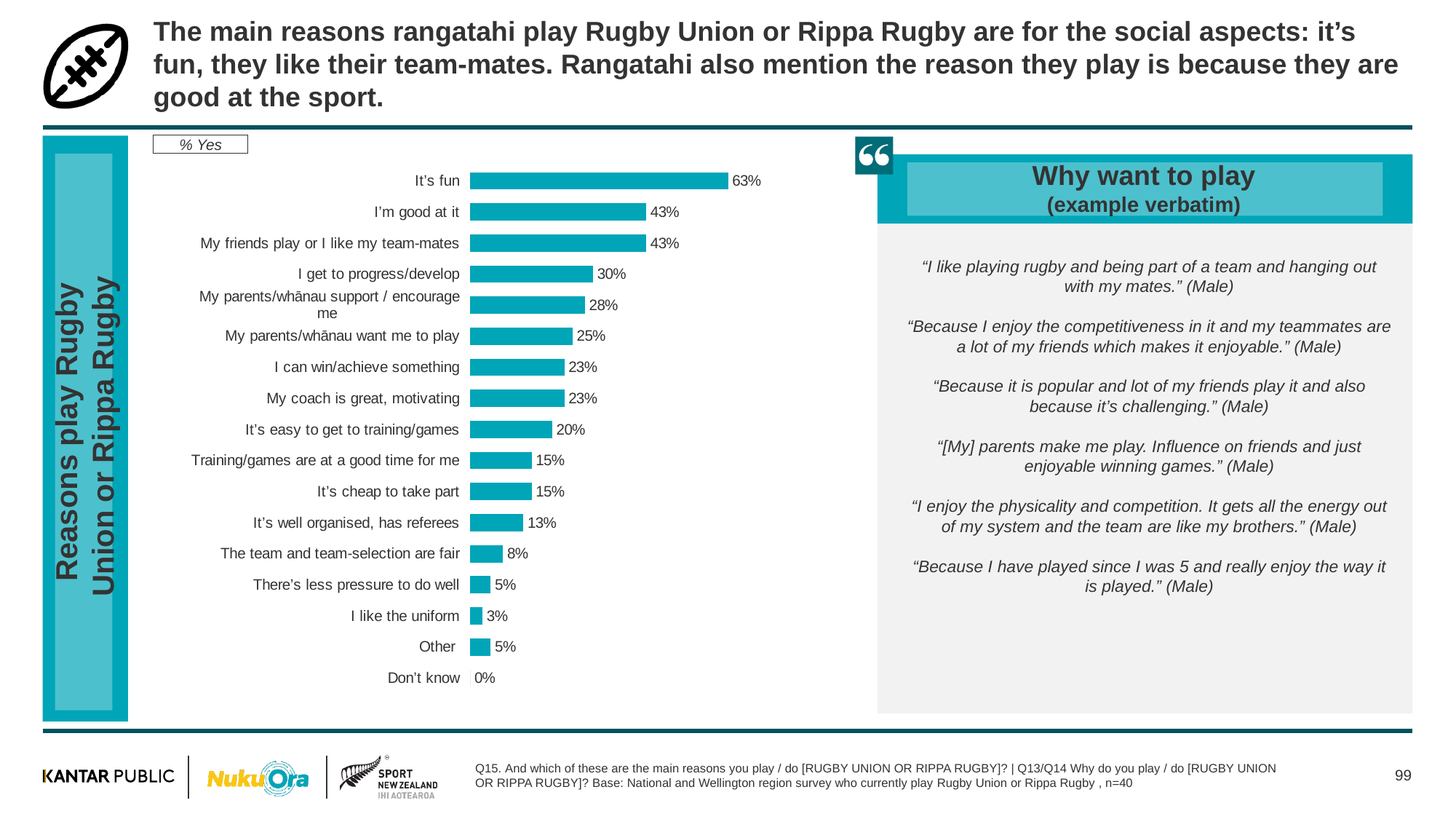
What label appears in the box above the chart indicating the measure shown? % Yes Which category has the lowest value in the chart? Don't know What is the value for "I'm good at it"? 43% Which is larger: "I get to progress/develop" or "My parents/whānau want me to play"? I get to progress/develop What is the difference in percentage points between "It's fun" and "My friends play or I like my team-mates"? 20 percentage points What is the value for "It's well organised, has referees"? 13% Which reason has the highest percentage in the chart? It's fun What percentage is shown for "I like the uniform"? 3% What type of chart is used to show the reasons rangatahi play Rugby Union or Rippa Rugby? Bar chart What percentage is shown for "My parents/whānau support / encourage me"? 28% How many reasons (categories) are listed in the bar chart? 17 What percentage of rangatahi say they play Rugby Union or Rippa Rugby because it's fun? 63%